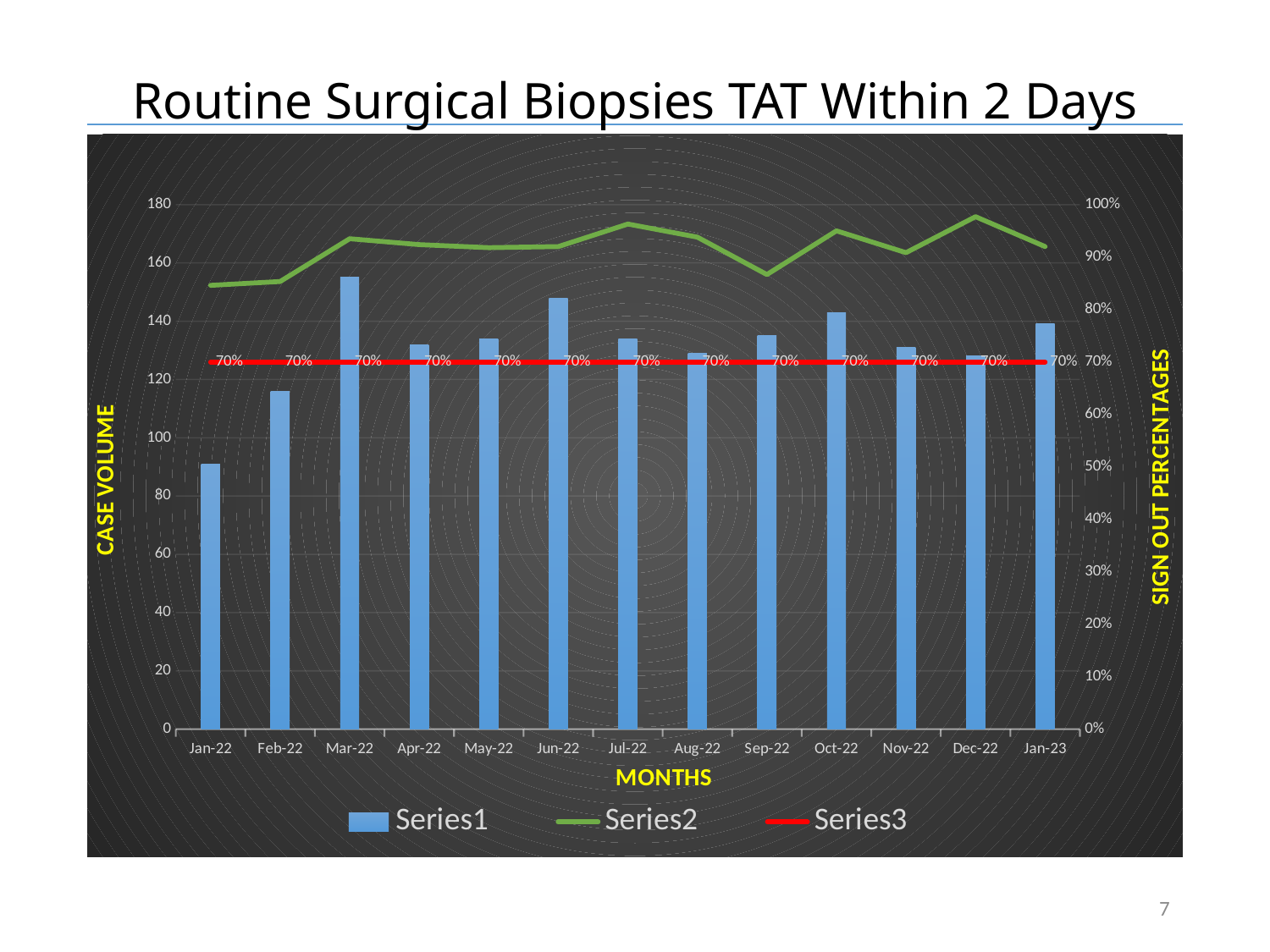
Which month has the highest Series1 bar? Mar-22 Which month has the lowest Series1 bar? Jan-22 Is the Series1 value for Jan-22 greater or less than 100? less How many series does the chart legend list? 3 What kind of chart is shown on the slide? A combination bar and line chart Is the Series1 value for Mar-22 greater or less than 140? greater Which month has the larger Series1 bar, Jan-22 or Feb-22? Feb-22 What is the value of Series3 for Jun-22? 70% Is the Series2 value for Sep-22 greater or less than 90%? less How many months are shown on the x axis of the chart? 13 Does the Series3 line rise, fall or stay flat across the months? Stays flat What is the title of the chart on the slide? Routine Surgical Biopsies TAT Within 2 Days